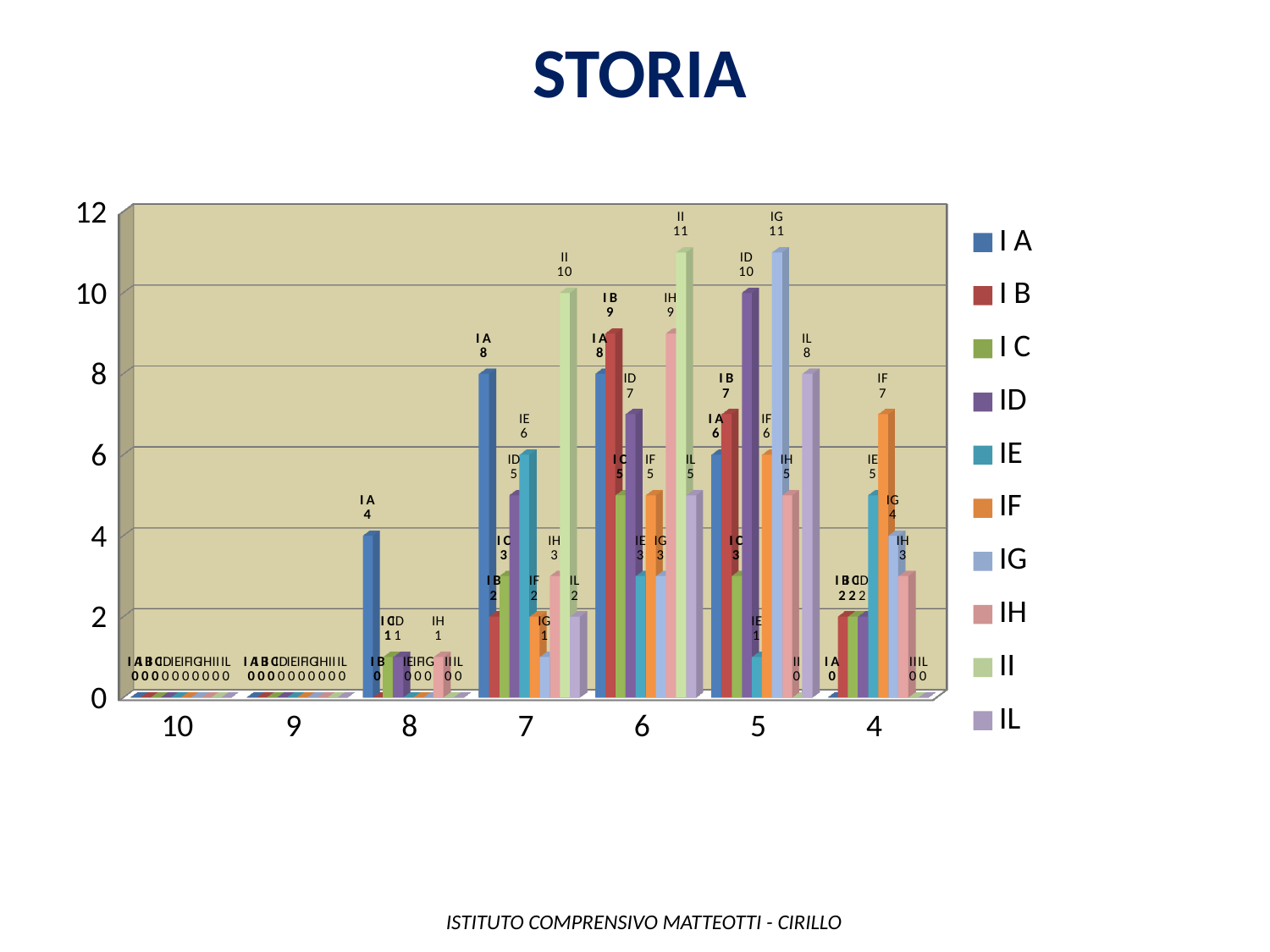
What kind of chart is shown on the slide? bar chart What is the value for series I A in category 8? 4 What is the value for series II in category 6? 11 In category 5, which series has the highest value? IG Which is larger for series ID: the value in category 5 or the value in category 6? category 5 What is the value for series IG in category 5? 11 What is the value for series I A in category 7? 8 What is the difference between the value of I B in category 6 and the value of I B in category 7? 7 What is the title of the chart? STORIA What is the value for series IF in category 4? 7 How many series does the legend list? 10 How many categories are shown on the x axis? 7